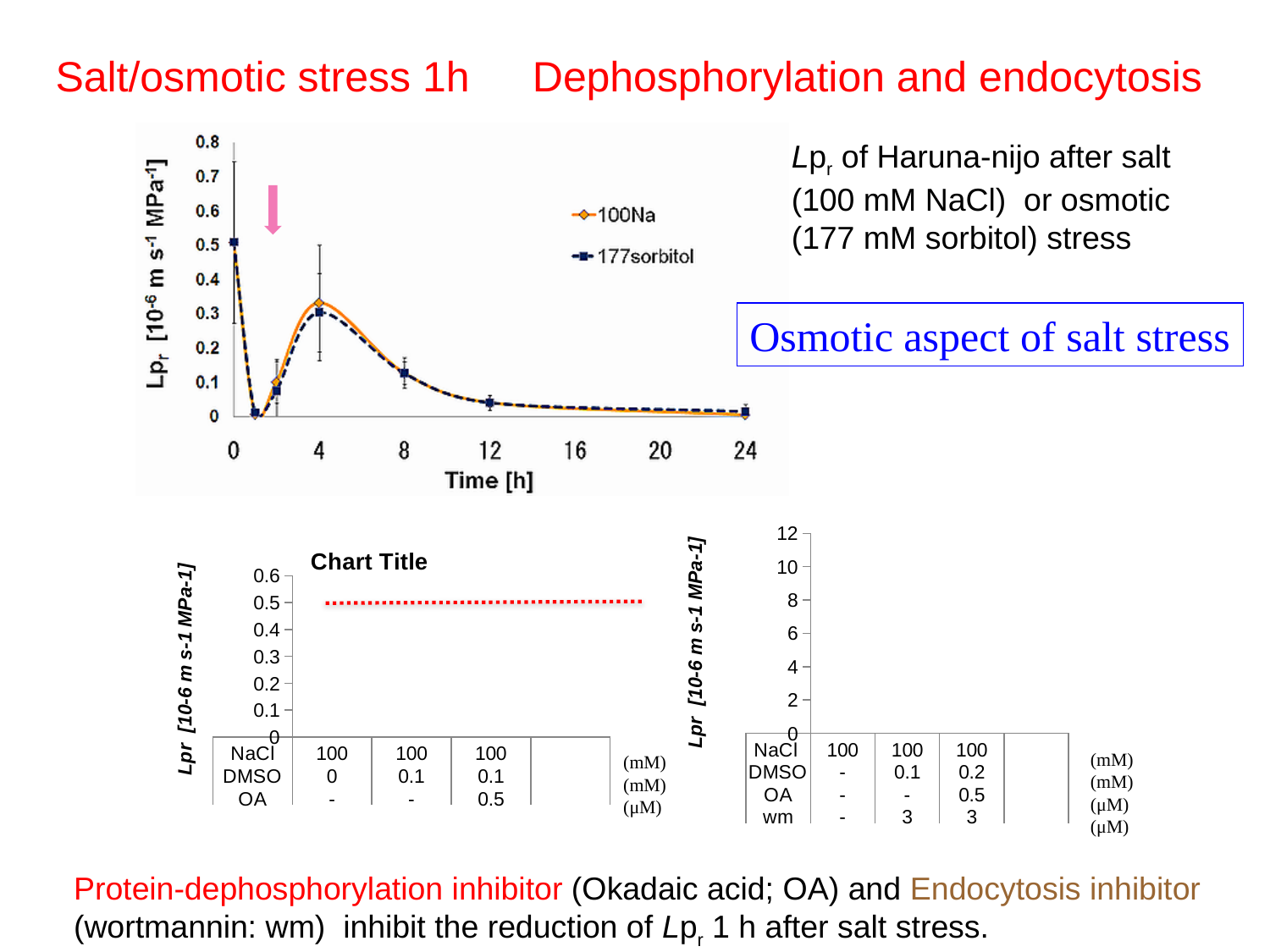
In the top chart (Lpr vs Time), is the value at 1 h greater or less than 0.1? less In the top chart (Lpr vs Time), do the values rise or fall between 4 h and 24 h? fall In the top chart (Lpr vs Time), is the value at 0 h larger or smaller than the value at 4 h? larger In the top chart (Lpr vs Time), is the 100Na value at 4 h greater or less than 0.4? less In the top chart (Lpr vs Time), at which time point is Lpr highest? 0 h What is the maximum value shown on the y axis of the bottom-right chart? 12 In the top chart (Lpr vs Time), what are the two series named in the legend? 100Na and 177sorbitol What is the title printed on the bottom-left chart? Chart Title In the top chart (Lpr vs Time), is the value at 24 h greater or less than 0.1? less How many series does the legend of the top chart (Lpr vs Time) list? 2 In the bottom-right chart, what wm value is listed for the third category column? 3 What kind of chart is the top chart showing Lpr against Time [h]? line chart